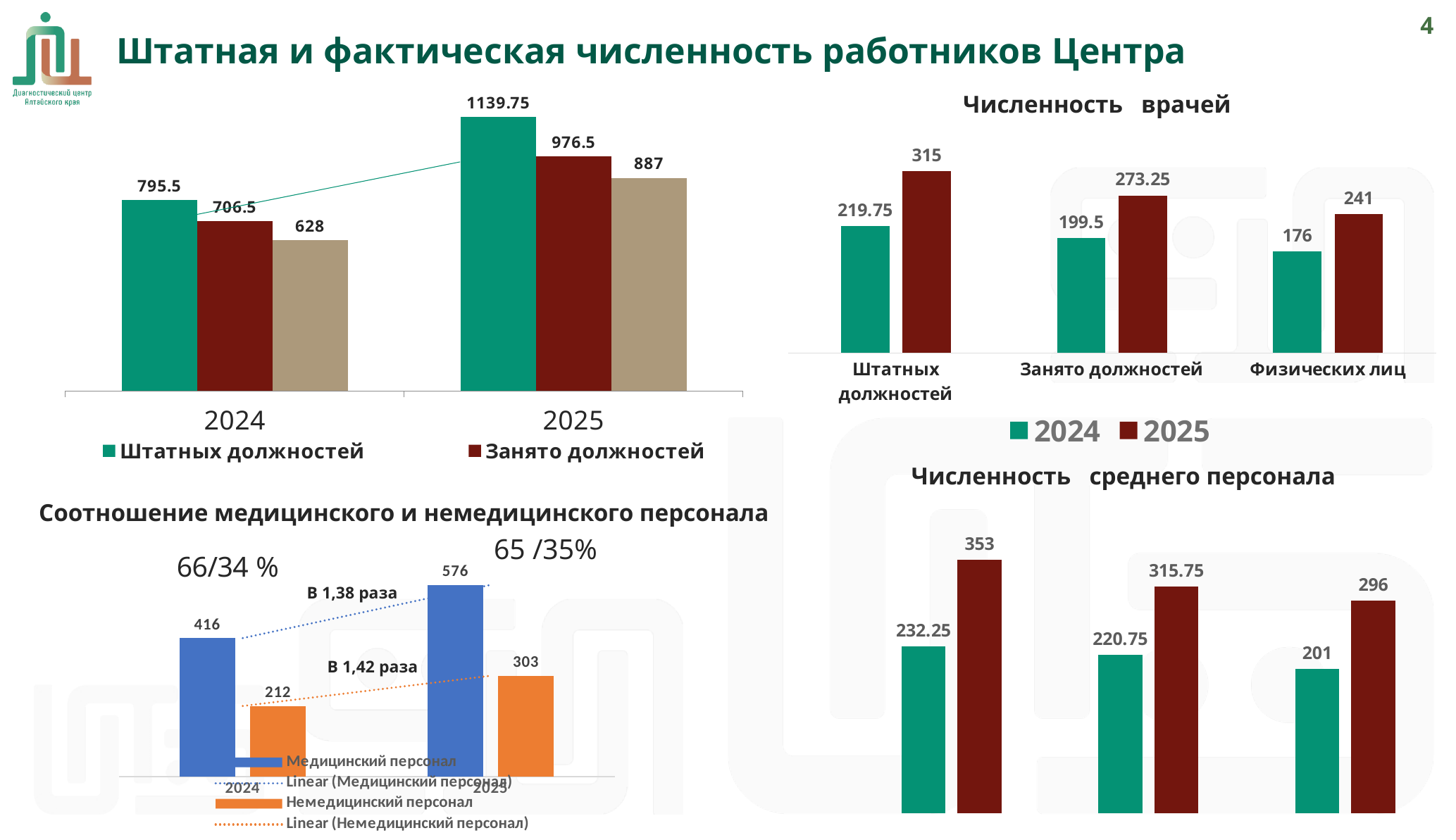
In the chart 'Численность врачей', what is the 2025 value for Физических лиц? 241 What type of chart is 'Численность врачей'? bar chart In the chart 'Соотношение медицинского и немедицинского персонала', which is larger in 2024: Медицинский персонал or Немедицинский персонал? Медицинский персонал In the chart 'Численность врачей', which category has the highest 2025 value? Штатных должностей In the chart 'Численность среднего персонала', what is the difference between the 2025 and 2024 values for the third category (Физических лиц)? 95 In the chart 'Численность среднего персонала', what is the 2025 value for the first category (Штатных должностей)? 353 In the top-left chart, what is the value of Занято должностей for 2024? 706.5 In the top-left chart, what is the value of Штатных должностей for 2025? 1139.75 In the chart 'Соотношение медицинского и немедицинского персонала', what is the value of Немедицинский персонал for 2025? 303 In the chart 'Численность врачей', what is the 2024 value for Занято должностей? 199.5 In the chart 'Численность врачей', how many categories are shown on the x axis? 3 In the top-left chart, by how much did Штатных должностей increase from 2024 to 2025? 344.25